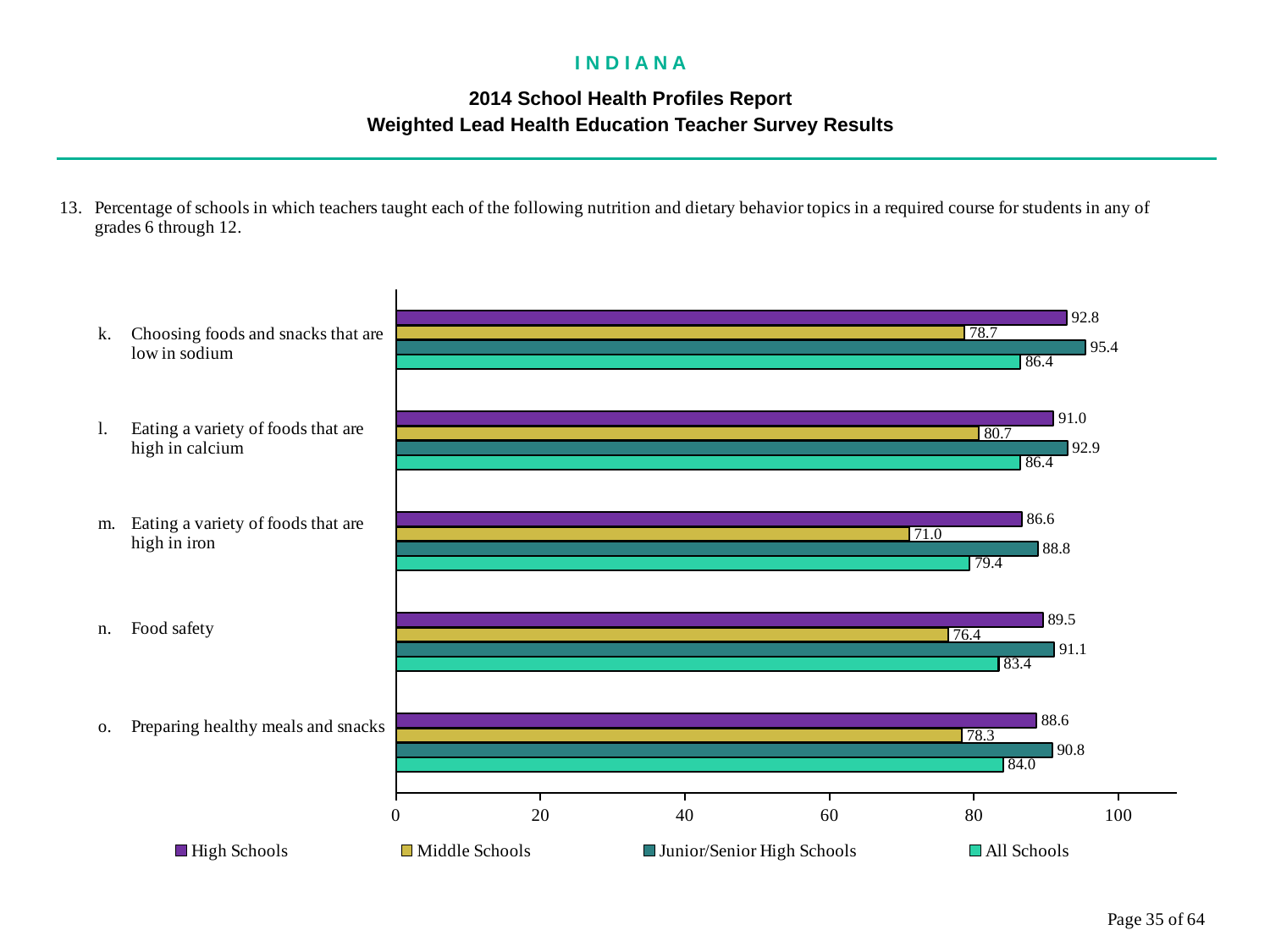
Which topic has the highest value for Junior/Senior High Schools? Choosing foods and snacks that are low in sodium How many series does the legend list? 4 What is the value for Middle Schools for 'Eating a variety of foods that are high in iron'? 71.0 What is the value for Junior/Senior High Schools for 'Preparing healthy meals and snacks'? 90.8 Is the All Schools value for 'Eating a variety of foods that are high in iron' greater or less than 80? less What is the value for High Schools for 'Choosing foods and snacks that are low in sodium'? 92.8 What is the value for All Schools for 'Food safety'? 83.4 For 'Food safety', which is larger: the High Schools value or the Junior/Senior High Schools value? Junior/Senior High Schools What is the difference between the High Schools and Middle Schools values for 'Eating a variety of foods that are high in calcium'? 10.3 Which topic has the lowest value for Middle Schools? Eating a variety of foods that are high in iron What kind of chart is shown on the slide? bar chart How many nutrition and dietary behavior topics are shown on the chart? 5